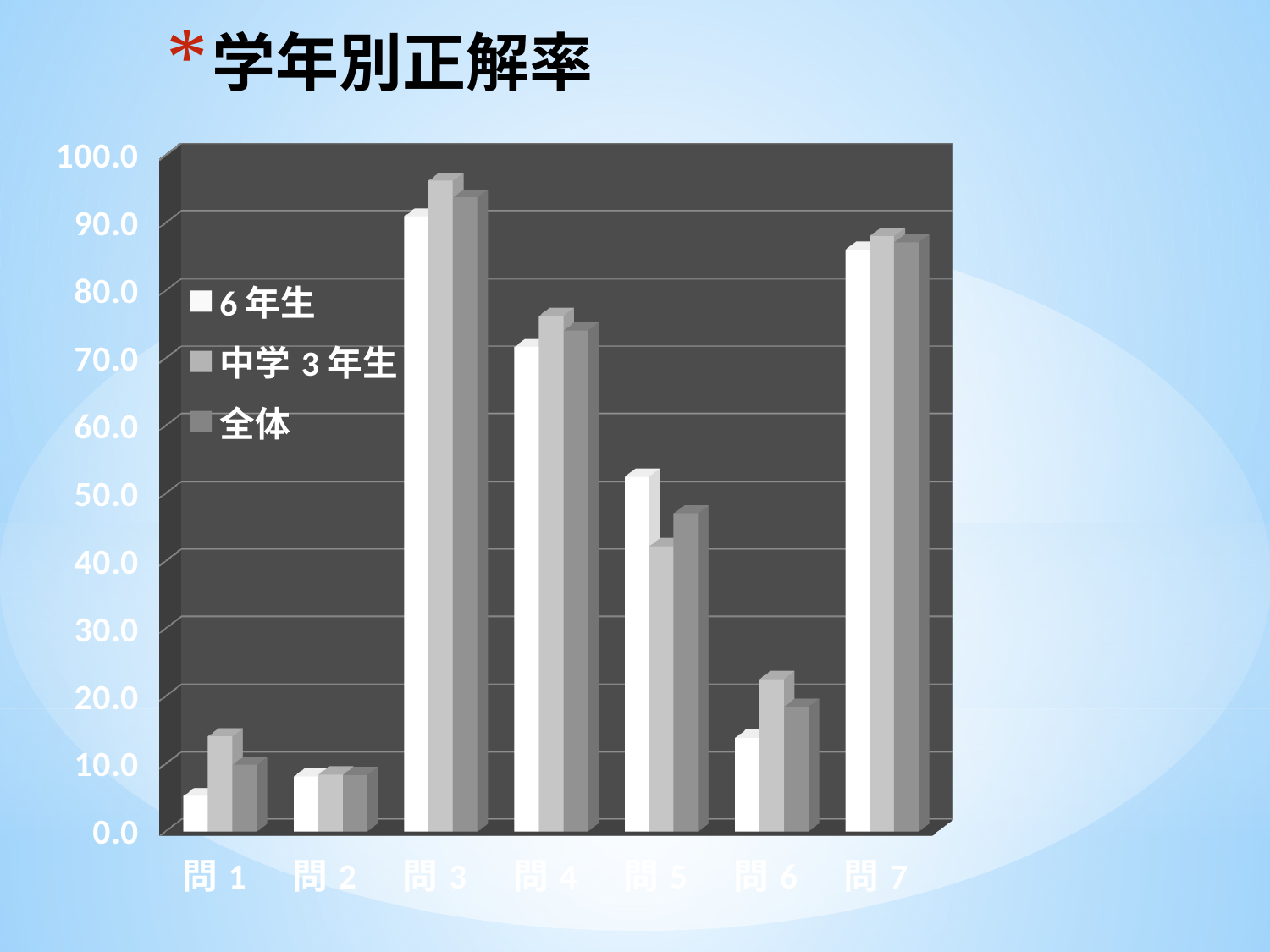
Is the 中学3年生 value for 問5 greater or less than 50.0? less For 問6, which is larger: the 6年生 value or the 中学3年生 value? 中学3年生 Which series is listed first in the legend? 6年生 What is the title of the chart? 学年別正解率 What kind of chart is shown on the slide? bar chart For which question is the 6年生 value lowest? 問1 How many series does the legend list? 3 For 問5, which is larger: the 6年生 value or the 中学3年生 value? 6年生 For which question is the 中学3年生 value highest? 問3 Is the 6年生 value for 問4 greater or less than 60.0? greater How many question categories are shown along the x axis? 7 For which question is the 6年生 value highest? 問3